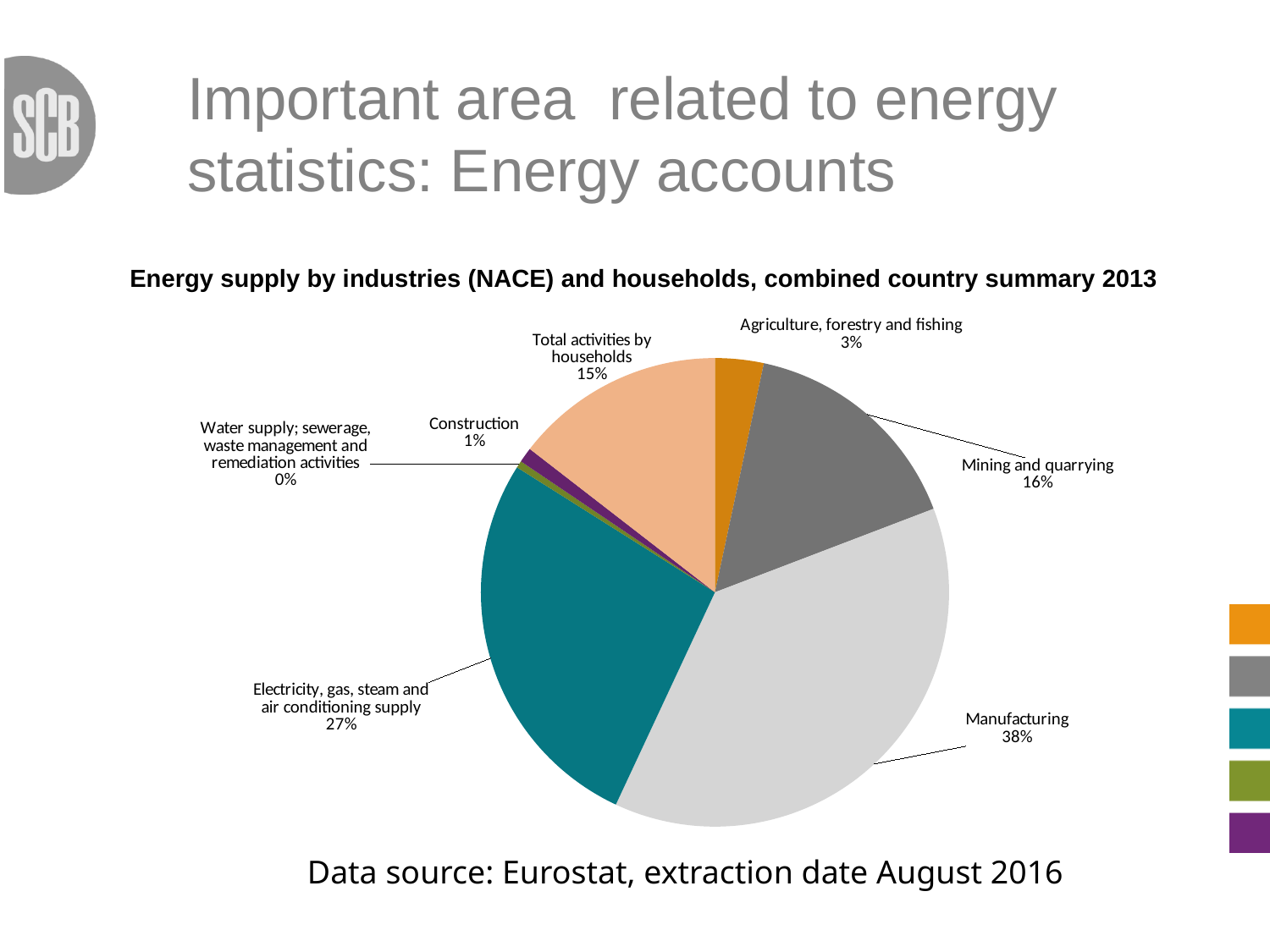
What share of energy supply does Manufacturing account for? 38% What is the difference in percentage points between Manufacturing and Electricity, gas, steam and air conditioning supply? 11 percentage points How many categories are shown in the pie chart? 7 What is the value for Agriculture, forestry and fishing? 3% Which is larger, Mining and quarrying or Total activities by households? Mining and quarrying What is the value for Electricity, gas, steam and air conditioning supply? 27% What is the value for Construction? 1% What is the value for Total activities by households? 15% Which category has the smallest share of the pie? Water supply; sewerage, waste management and remediation activities What is the value for Mining and quarrying? 16% What kind of chart is shown on the slide? pie chart Which category has the largest share of the pie? Manufacturing